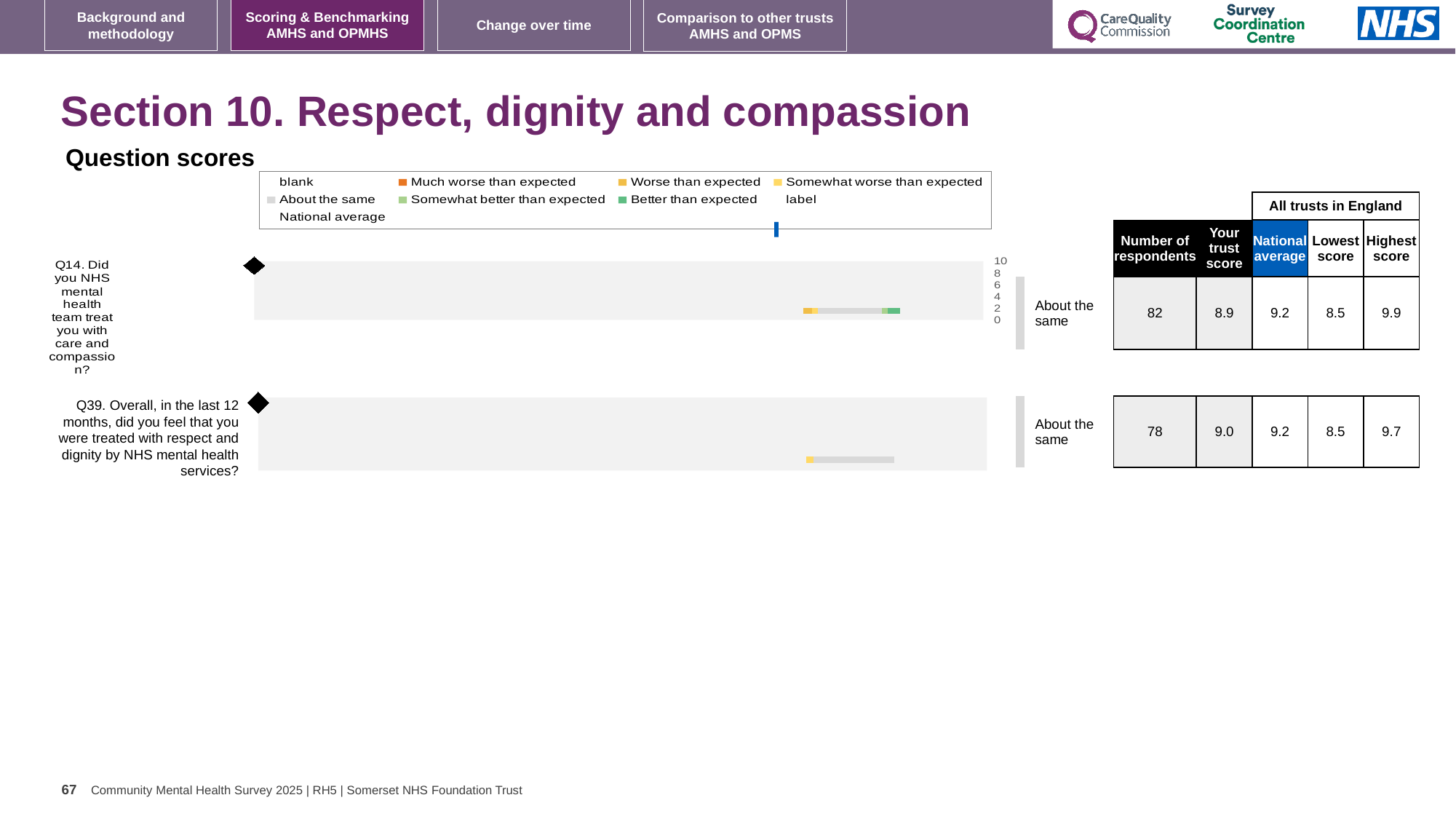
What is the highest score among all trusts in England for Q39? 9.7 What is the trust score for Q39 (respect and dignity)? 9.0 What kind of chart is used to show the question scores on this slide? bar chart How many respondents answered Q14? 82 What is the national average score for Q14? 9.2 What is the trust score for Q14 (care and compassion)? 8.9 Which legend entry is shown in dark green? Better than expected What is the difference between the highest score and the lowest score for Q14? 1.4 How many respondents answered Q39? 78 What benchmark category is shown for Q14? About the same Which question has the higher trust score, Q14 or Q39? Q39 How many questions are plotted in the question scores chart? 2